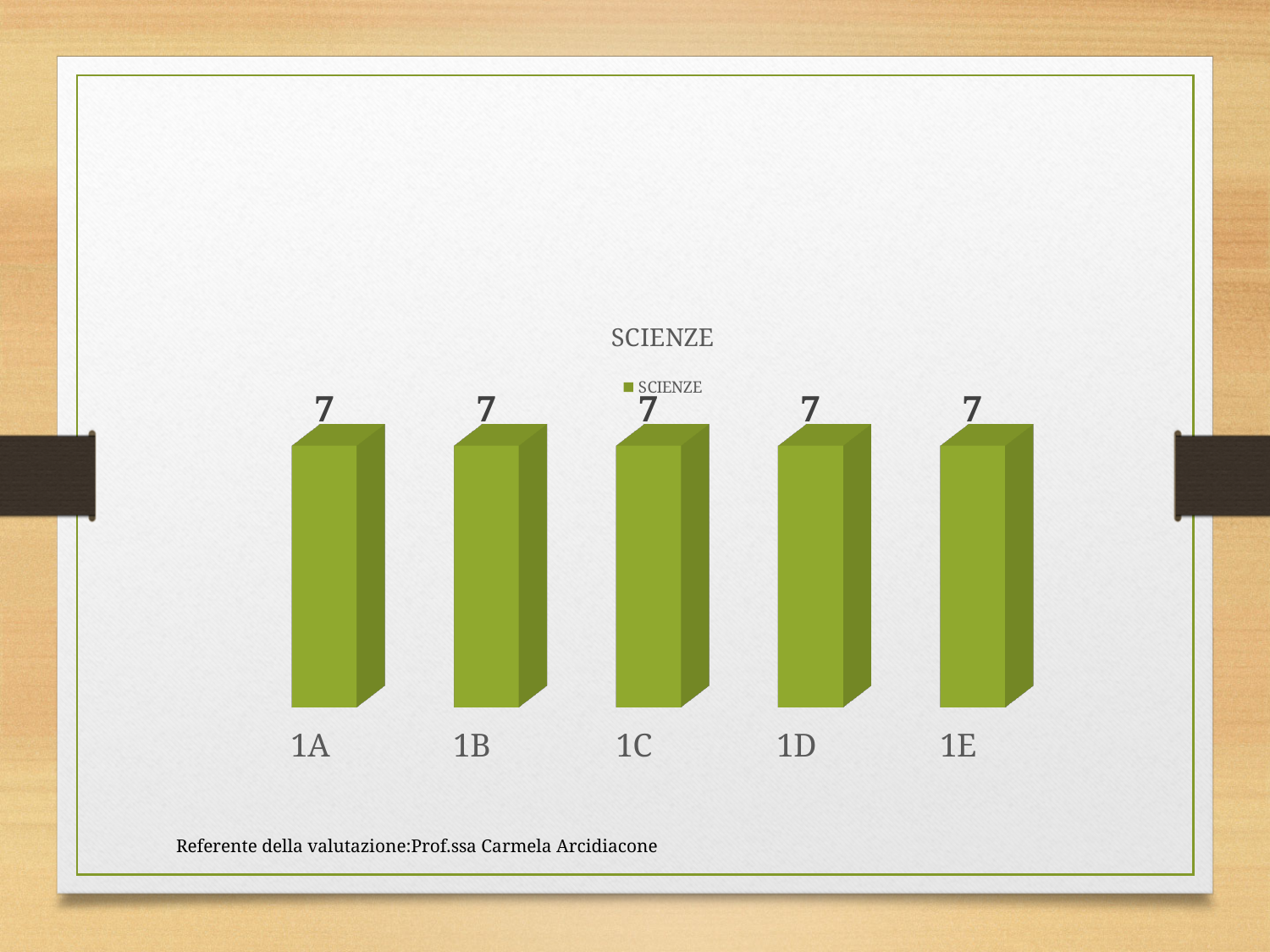
How many series does the legend list? 1 What is the value for 1E? 7 What is the total of the values for 1A and 1B? 14 What is the value for 1C? 7 How many categories are shown on the x axis? 5 Do the values rise, fall or stay the same from 1A to 1E? stay the same What is the name of the series in the legend? SCIENZE What is the difference between the values for 1B and 1D? 0 What is the title of the chart? SCIENZE What is the value for 1A? 7 What kind of chart is shown? bar chart